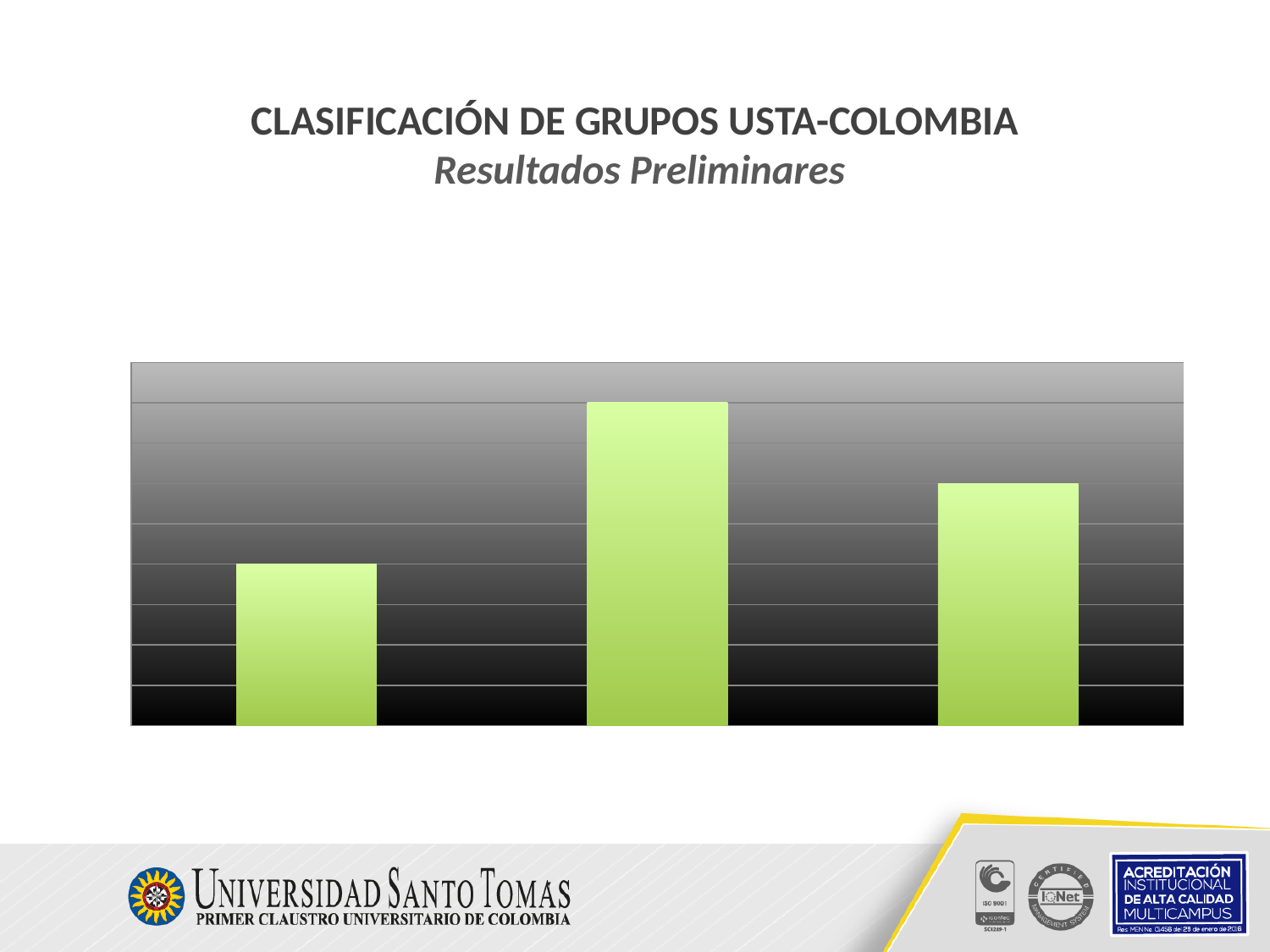
Is the left bar taller or shorter than the right bar? shorter What is the title shown above the chart on the slide? CLASIFICACIÓN DE GRUPOS USTA-COLOMBIA Resultados Preliminares Does the value rise or fall from the second bar to the third bar? fall Does the value rise or fall from the first bar to the second bar? rise Is the middle bar taller or shorter than the right bar? taller How many bars are plotted in the chart? 3 What kind of chart is shown on the slide? bar chart What colour are the bars in the chart? green Which bar is the shortest in the chart: the left, middle or right one? left Which bar is the tallest in the chart: the left, middle or right one? middle